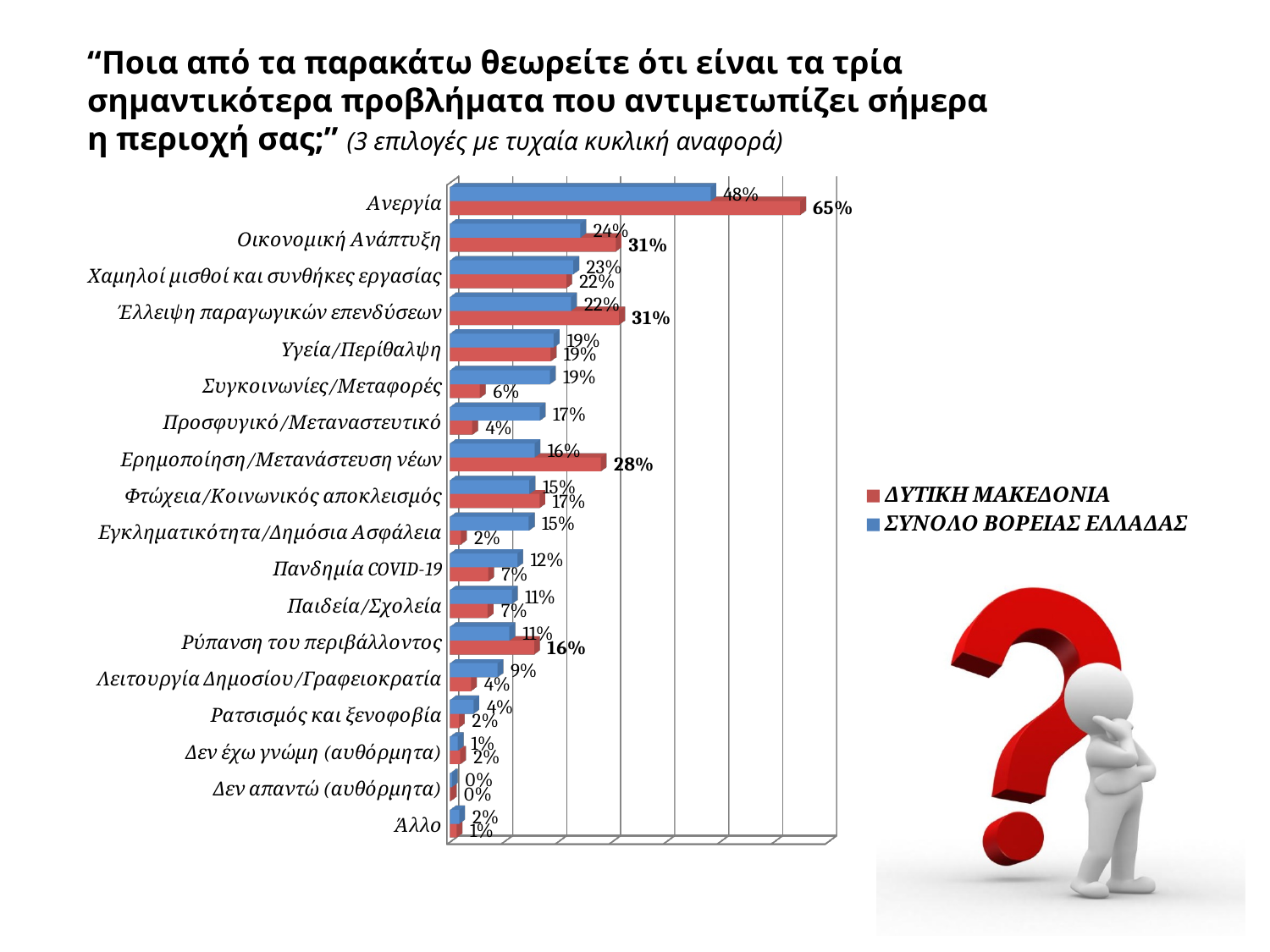
Which category has the lowest value in the ΣΥΝΟΛΟ ΒΟΡΕΙΑΣ ΕΛΛΑΔΑΣ series? Δεν απαντώ (αυθόρμητα) What is the value for Ανεργία in the ΔΥΤΙΚΗ ΜΑΚΕΔΟΝΙΑ series? 65% What is the value for Ανεργία in the ΣΥΝΟΛΟ ΒΟΡΕΙΑΣ ΕΛΛΑΔΑΣ series? 48% What is the difference between the ΔΥΤΙΚΗ ΜΑΚΕΔΟΝΙΑ and ΣΥΝΟΛΟ ΒΟΡΕΙΑΣ ΕΛΛΑΔΑΣ values for Ανεργία? 17% What is the value for Ερημοποίηση/Μετανάστευση νέων in the ΔΥΤΙΚΗ ΜΑΚΕΔΟΝΙΑ series? 28% How many categories are shown on the chart? 18 Which category has the highest value in the ΔΥΤΙΚΗ ΜΑΚΕΔΟΝΙΑ series? Ανεργία For Προσφυγικό/Μεταναστευτικό, which series has the larger value, ΔΥΤΙΚΗ ΜΑΚΕΔΟΝΙΑ or ΣΥΝΟΛΟ ΒΟΡΕΙΑΣ ΕΛΛΑΔΑΣ? ΣΥΝΟΛΟ ΒΟΡΕΙΑΣ ΕΛΛΑΔΑΣ How many series does the legend list? 2 What is the value for Συγκοινωνίες/Μεταφορές in the ΣΥΝΟΛΟ ΒΟΡΕΙΑΣ ΕΛΛΑΔΑΣ series? 19% What kind of chart is shown on the slide? bar chart Which colour represents the ΔΥΤΙΚΗ ΜΑΚΕΔΟΝΙΑ series? red